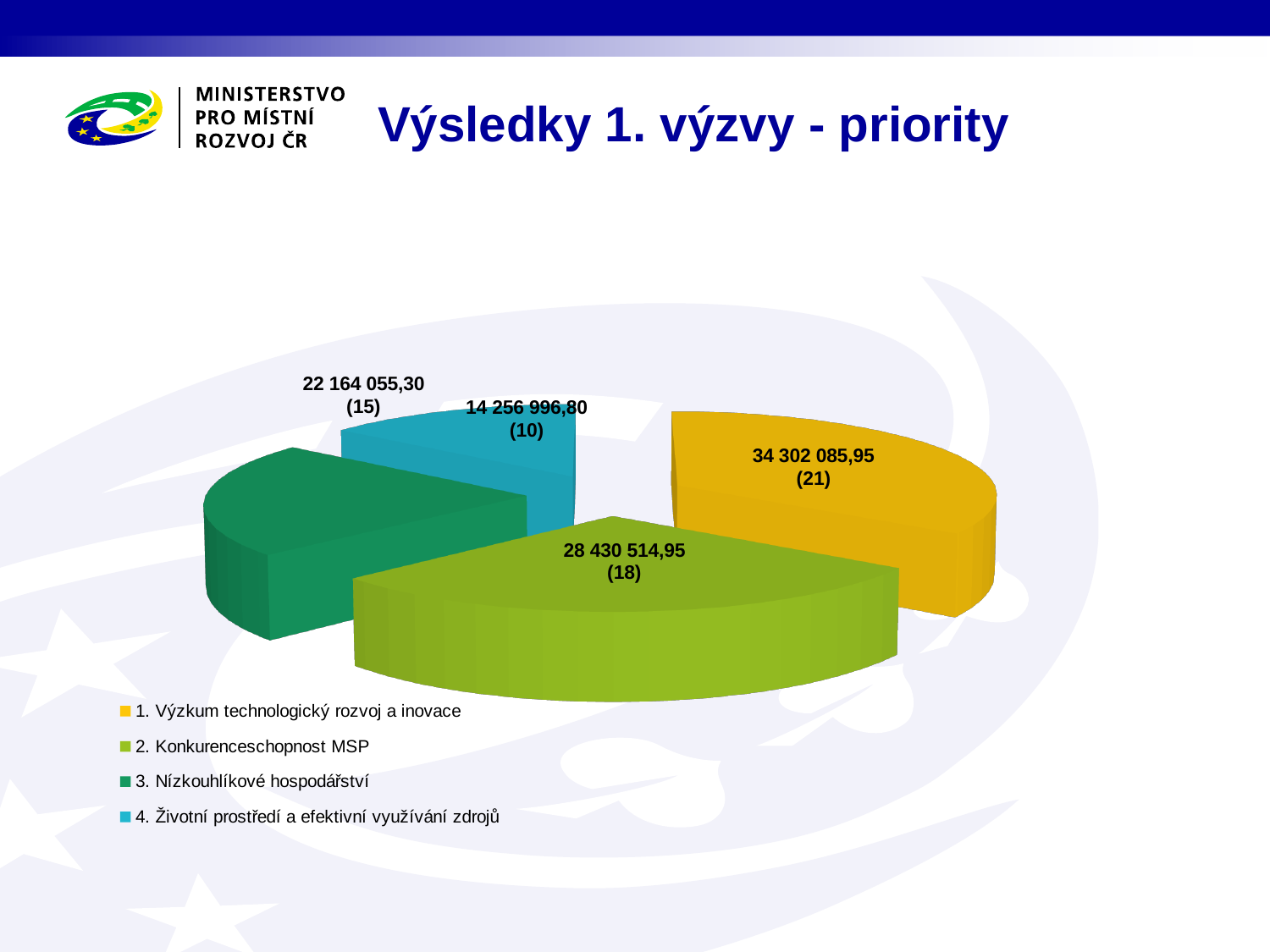
What number in parentheses is shown for the slice 2. Konkurenceschopnost MSP? 18 How many slices does the pie chart have? 4 Which priority has the largest slice of the pie? 1. Výzkum technologický rozvoj a inovace What value is labelled on the slice for 3. Nízkouhlíkové hospodářství? 22 164 055,30 Which is larger, the value for 3. Nízkouhlíkové hospodářství or for 4. Životní prostředí a efektivní využívání zdrojů? 3. Nízkouhlíkové hospodářství What kind of chart is shown on the slide? pie chart What value is labelled on the slice for 4. Životní prostředí a efektivní využívání zdrojů? 14 256 996,80 What is the difference between the values for 1. Výzkum technologický rozvoj a inovace and 2. Konkurenceschopnost MSP? 5 871 571,00 What value is labelled on the slice for 2. Konkurenceschopnost MSP? 28 430 514,95 What is the title of the slide containing the pie chart? Výsledky 1. výzvy - priority Which priority has the smallest slice of the pie? 4. Životní prostředí a efektivní využívání zdrojů What value is labelled on the slice for 1. Výzkum technologický rozvoj a inovace? 34 302 085,95